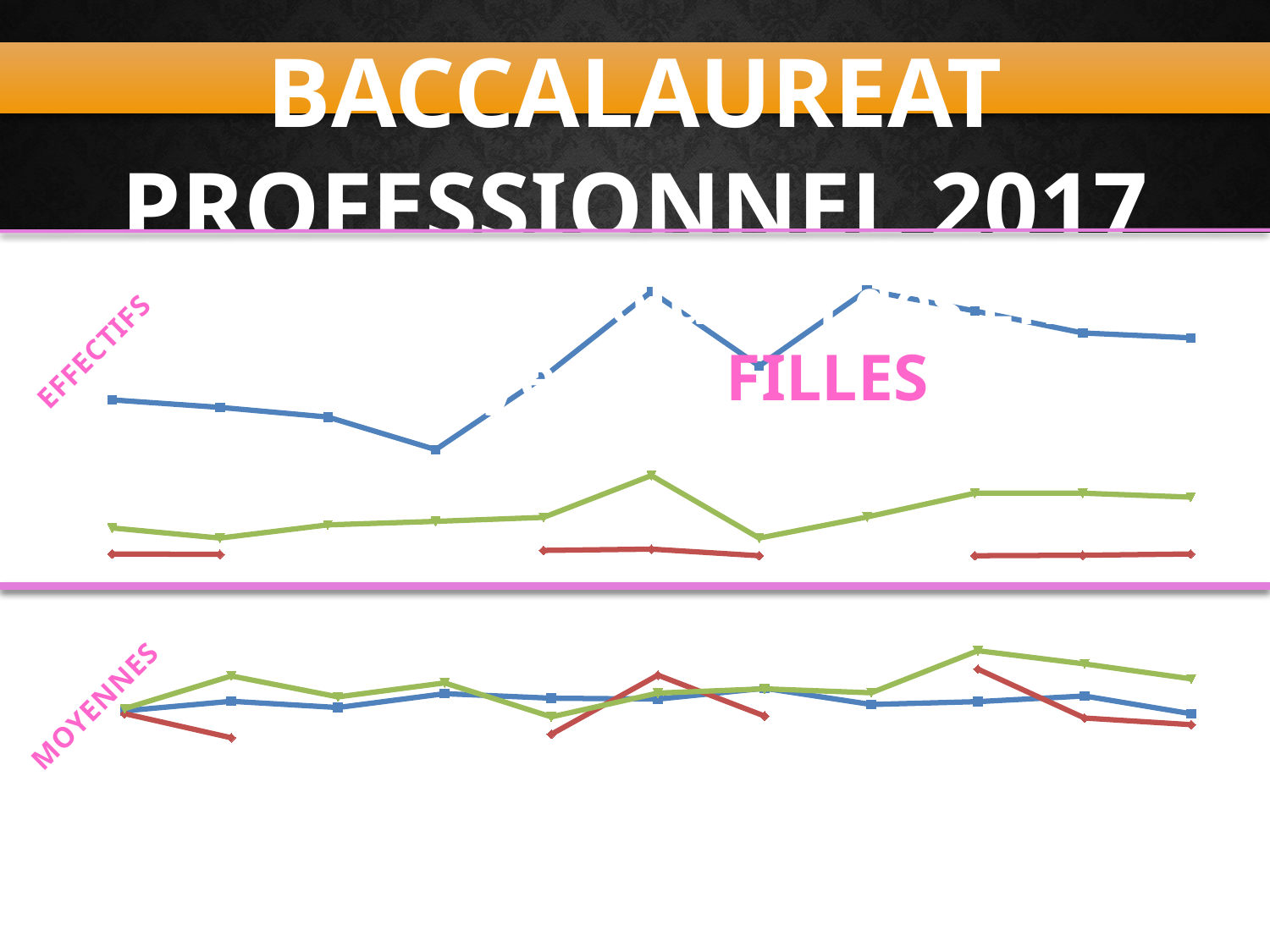
In the EFFECTIFS chart, which coloured line lies lowest across the chart? red What kind of chart is the EFFECTIFS chart at the top of the slide? line chart How many lines are plotted in the EFFECTIFS chart? 3 What label is written beside the bottom chart on the slide? MOYENNES In the MOYENNES chart, which coloured line is highest at the last point on the right? green In the EFFECTIFS chart, which coloured line lies highest across the chart? blue What label is written beside the top chart on the slide? EFFECTIFS In the EFFECTIFS chart, does the blue line end higher or lower than it starts? higher In the EFFECTIFS chart, does the green line end higher or lower than it starts? higher What kind of chart is the MOYENNES chart at the bottom of the slide? line chart How many lines are plotted in the MOYENNES chart? 3 In the MOYENNES chart, which coloured line is lowest at the last point on the right? red